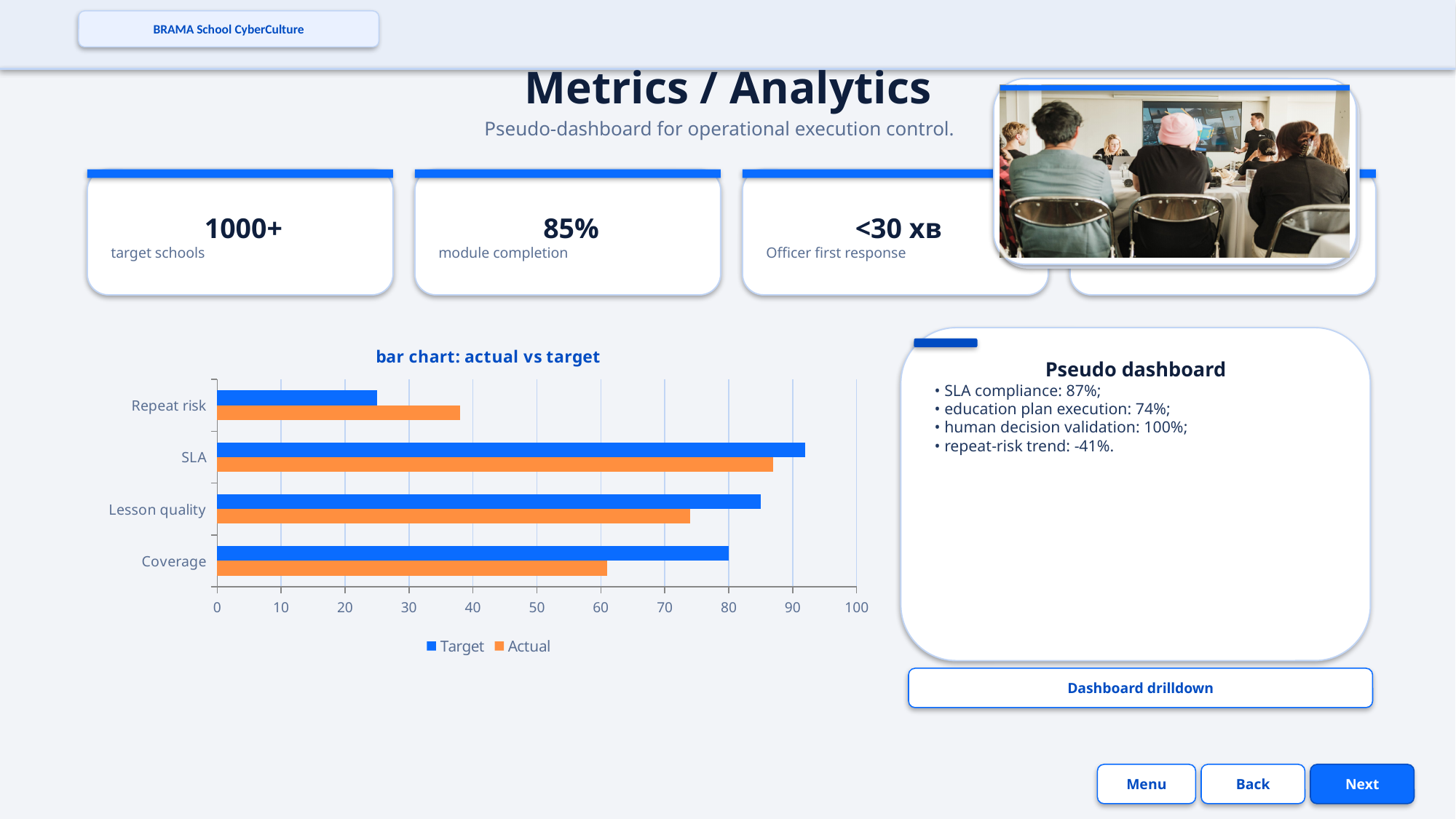
How many series does the chart legend list? 2 Which category has the lowest Actual value? Repeat risk Is the Actual value for Coverage greater or less than 70? less Which category has the lowest Target value? Repeat risk Which category has the highest Actual value? SLA For Repeat risk, which is larger, the Target value or the Actual value? Actual What is the title of the chart? bar chart: actual vs target Is the Target value for SLA greater or less than 90? greater Which category has the highest Target value? SLA What kind of chart is shown on the slide? bar chart For Lesson quality, which is larger, the Target value or the Actual value? Target How many categories are shown on the chart? 4